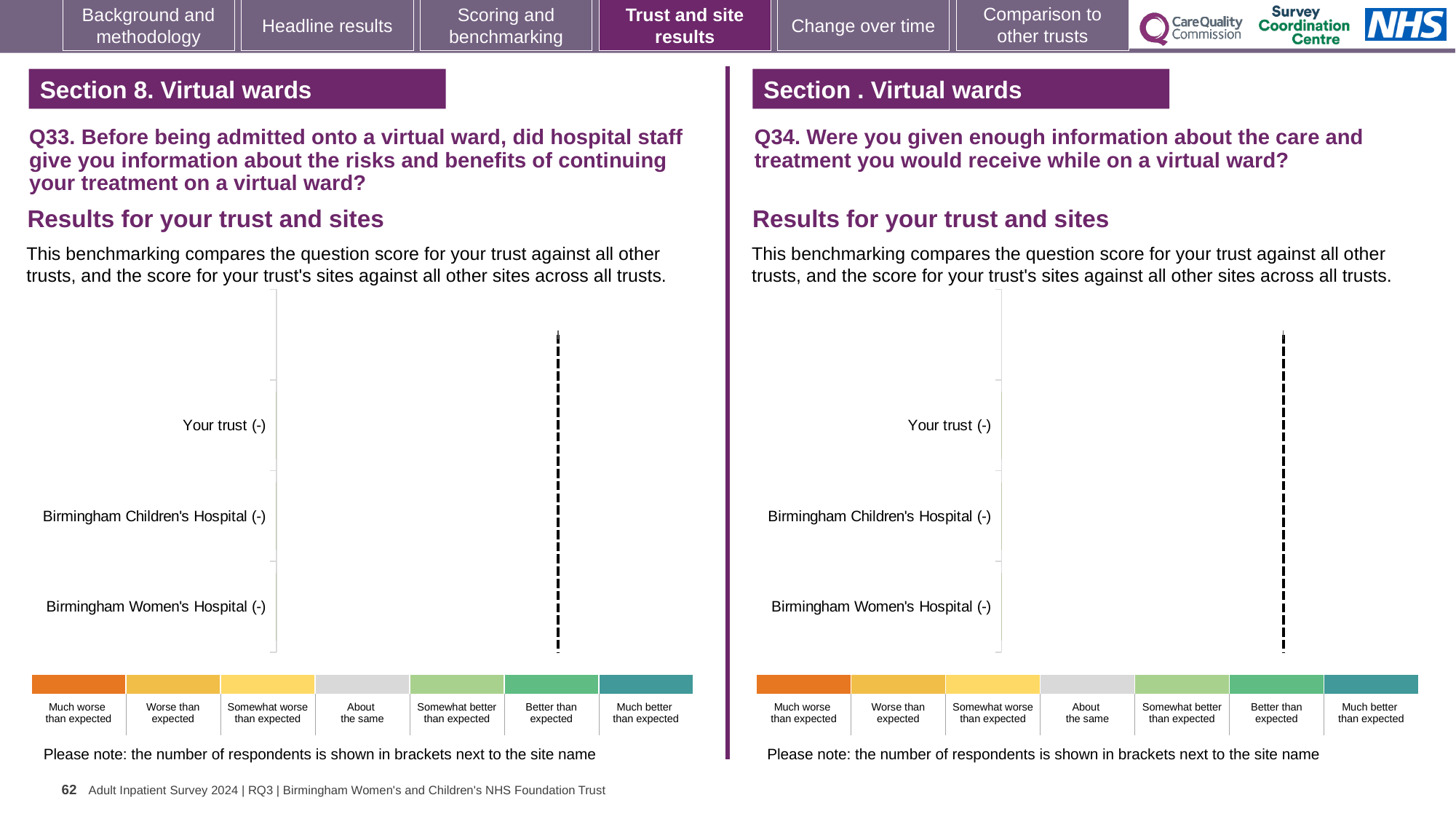
How many colour categories does the legend below the right chart (Q34) show? 7 How many colour categories does the legend below the left chart (Q33) show? 7 On the right chart (Q34), how many categories are listed on the vertical axis? 3 On the right chart (Q34), what is the label of the bottom category on the axis? Birmingham Women's Hospital (-) On the left chart (Q33), what number of respondents is shown in brackets next to Birmingham Children's Hospital? - On the left chart (Q33), how many categories are listed on the vertical axis? 3 How many charts are shown on the slide? 2 On the right chart (Q34), what number of respondents is shown in brackets next to Your trust? - On the left chart (Q33), what is the label of the first category at the top of the axis? Your trust (-)